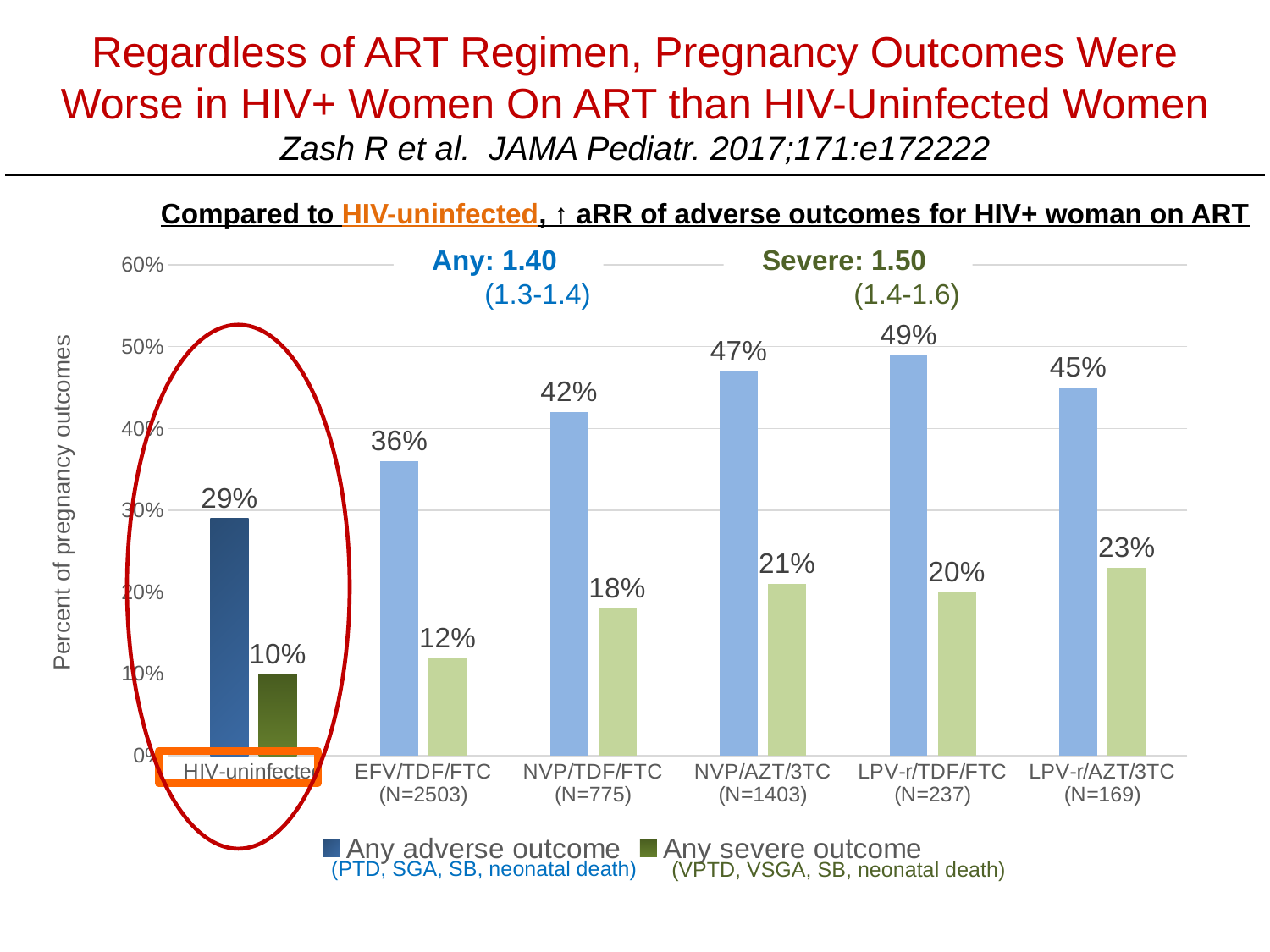
What is the difference between the 'Any adverse outcome' and 'Any severe outcome' values for LPV-r/TDF/FTC? 29% What is the value of 'Any adverse outcome' for the HIV-uninfected group? 29% What is the value of 'Any adverse outcome' for the LPV-r/AZT/3TC group? 45% What kind of chart is shown on the slide? Bar chart What is the difference between the 'Any adverse outcome' values for EFV/TDF/FTC and HIV-uninfected? 7% What is the value of 'Any severe outcome' for the NVP/TDF/FTC group? 18% Which is larger: the 'Any severe outcome' value for NVP/AZT/3TC or for LPV-r/TDF/FTC? NVP/AZT/3TC What is the label of the y axis? Percent of pregnancy outcomes Which group has the lowest value for 'Any severe outcome'? HIV-uninfected Which group has the highest value for 'Any adverse outcome'? LPV-r/TDF/FTC How many groups are shown on the x axis? 6 How many series does the legend list? 2